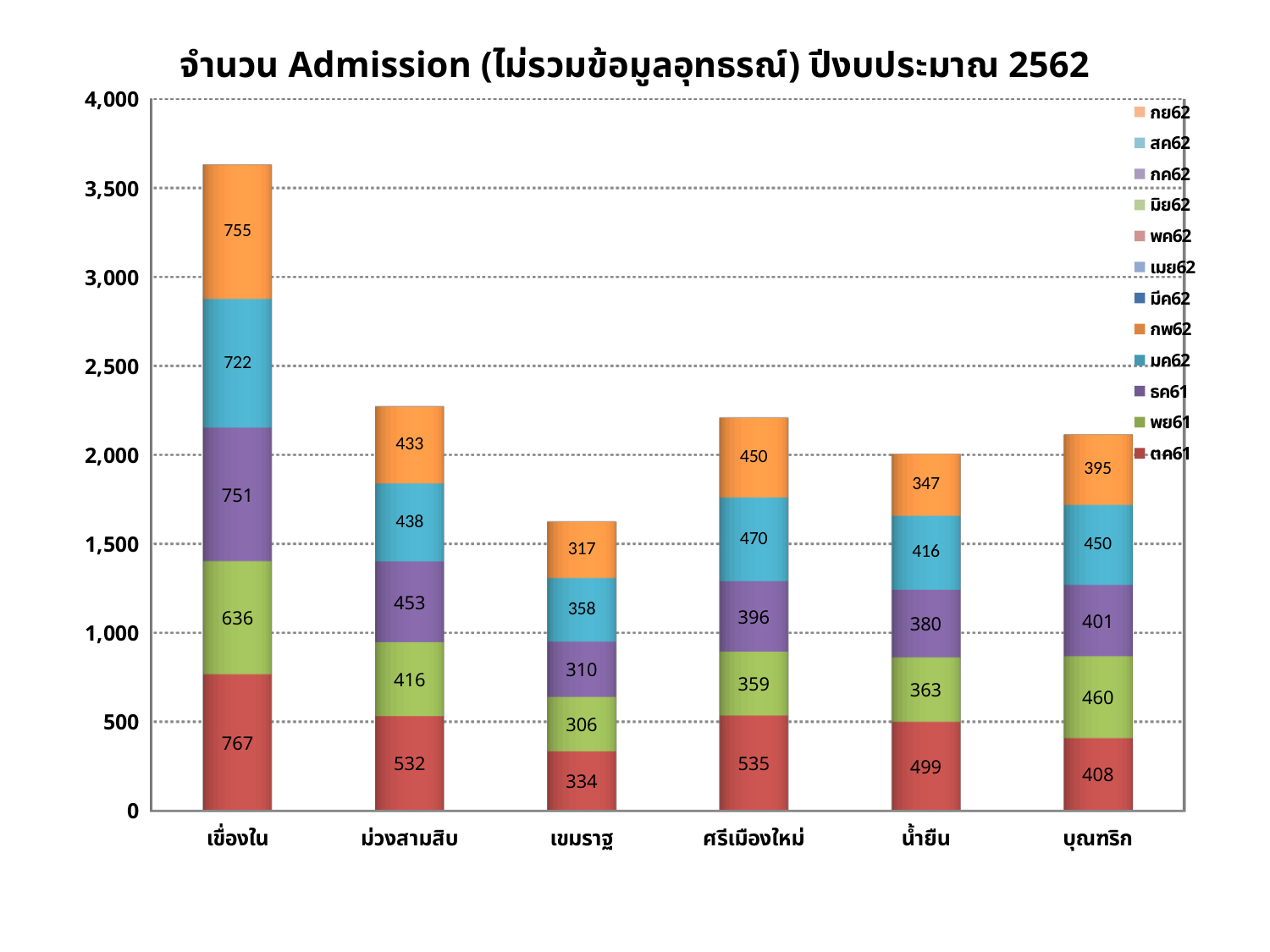
Which category has the tallest stacked bar? เขื่องใน What is the value of the กพ62 segment for น้ำยืน? 347 What type of chart is shown on the slide? Stacked bar chart What is the difference between the ตค61 values for เขื่องใน and ม่วงสามสิบ? 235 Which is larger, the พย61 value for บุณฑริก or the พย61 value for ม่วงสามสิบ? บุณฑริก How many series does the legend list? 12 What is the value of the มค62 segment for ศรีเมืองใหม่? 470 How many categories (hospitals) are shown on the x axis? 6 What is the total of the stacked bar for เขมราฐ? 1,625 What is the value of the ตค61 segment for เขื่องใน? 767 Which category has the shortest stacked bar? เขมราฐ Is the total stacked bar for น้ำยืน greater or less than 1,500? greater